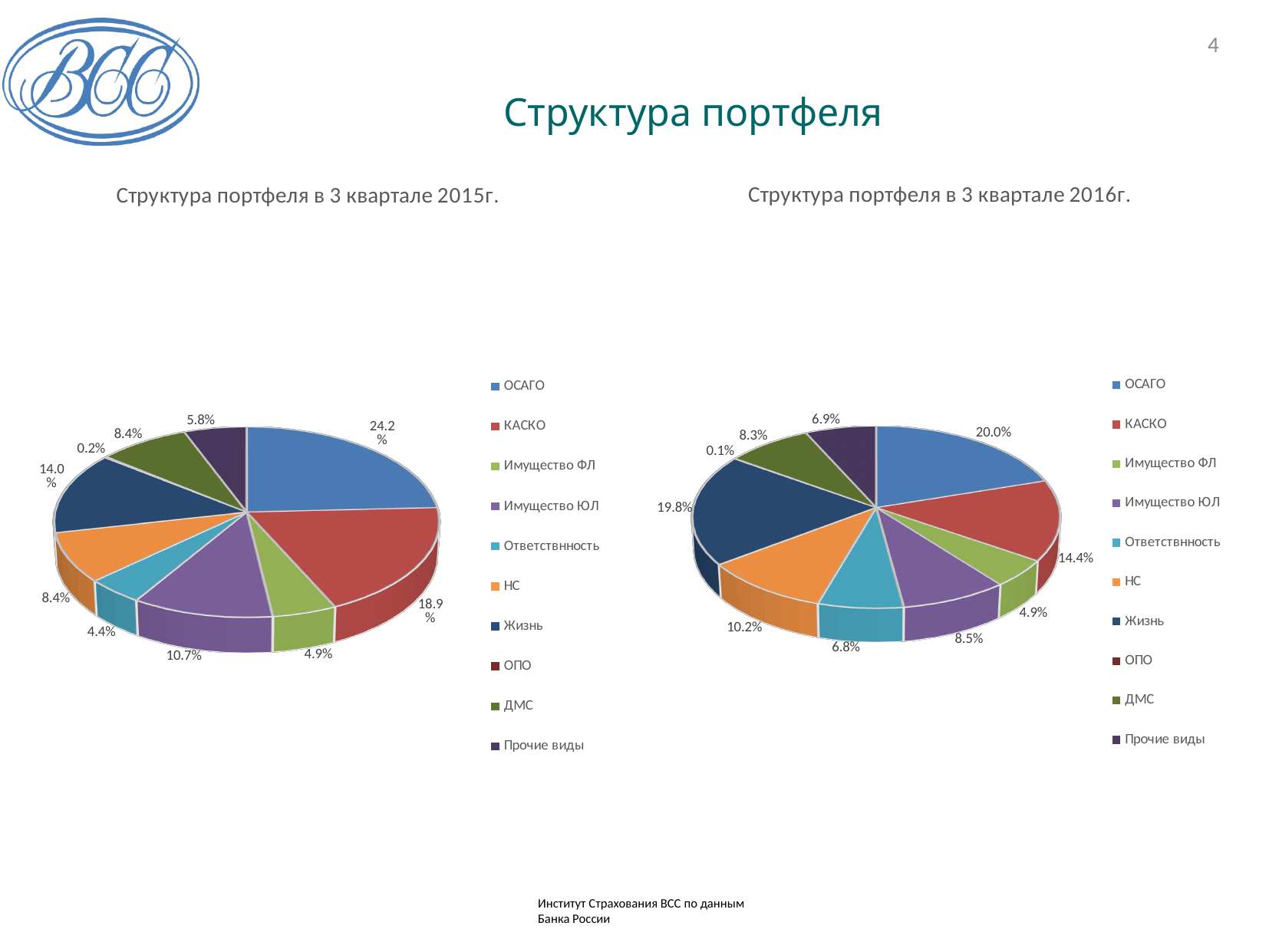
In the chart 'Структура портфеля в 3 квартале 2016г.', what is the difference between the shares of ОСАГО and Жизнь? 0.2% In the chart 'Структура портфеля в 3 квартале 2016г.', what share does Жизнь have? 19.8% In the chart 'Структура портфеля в 3 квартале 2015г.', what is the difference between the shares of ОСАГО and КАСКО? 5.3% In the chart 'Структура портфеля в 3 квартале 2016г.', what share does КАСКО have? 14.4% What type of chart is 'Структура портфеля в 3 квартале 2016г.'? Pie chart In the chart 'Структура портфеля в 3 квартале 2016г.', which is larger: the share of НС or the share of Имущество ЮЛ? НС In the chart 'Структура портфеля в 3 квартале 2015г.', what share does ОПО have? 0.2% In the chart 'Структура портфеля в 3 квартале 2016г.', which category has the smallest share? ОПО In the chart 'Структура портфеля в 3 квартале 2015г.', which category has the largest share? ОСАГО How many categories does the legend of the chart 'Структура портфеля в 3 квартале 2015г.' list? 10 In the chart 'Структура портфеля в 3 квартале 2015г.', what share does ОСАГО have? 24.2% What is the title of the chart on the left side of the slide? Структура портфеля в 3 квартале 2015г.